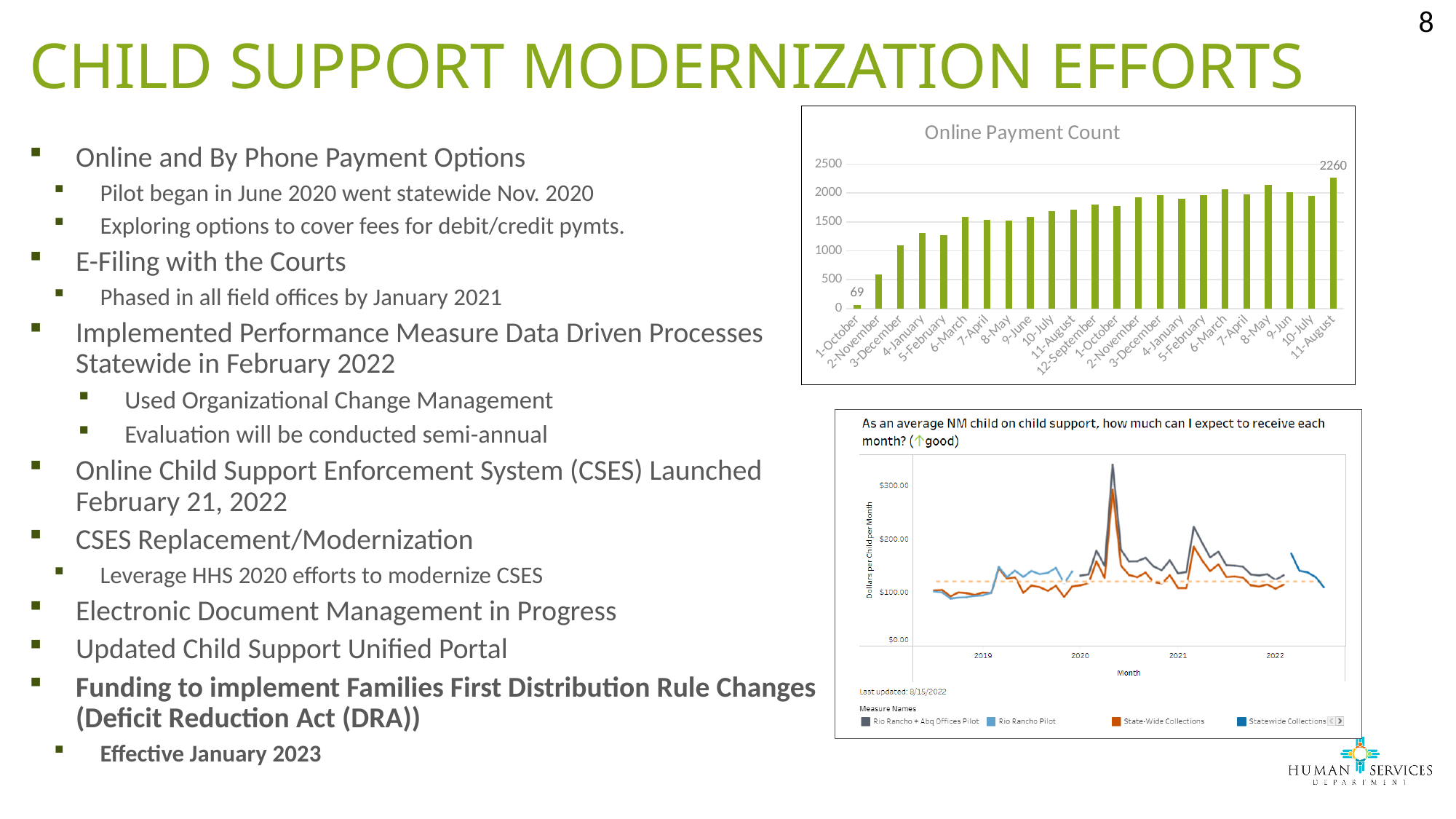
In the "Online Payment Count" chart, what is the value for the first 1-October bar? 69 In the "Online Payment Count" chart, do the values generally rise or fall from left to right? rise What is the y-axis label of the lower chart about how much an average NM child on child support can expect to receive each month? Dollars per Child per Month How many measure names does the legend of the lower line chart (dollars per child per month) list? 4 In the "Online Payment Count" chart, which month has the highest online payment count? 11-August (the last bar) What kind of chart is the "Online Payment Count" chart? bar chart In the "Online Payment Count" chart, which month has the lowest online payment count? 1-October (the first bar) In the "Online Payment Count" chart, what is the difference between the last bar (11-August) and the first bar (1-October)? 2191 How many bars are plotted in the "Online Payment Count" chart? 23 In the "Online Payment Count" chart, is the value for 12-September greater or less than 1500? greater In the "Online Payment Count" chart, what is the value for the final 11-August bar? 2260 In the "Online Payment Count" chart, is the value for the first 2-November bar greater or less than 1000? less